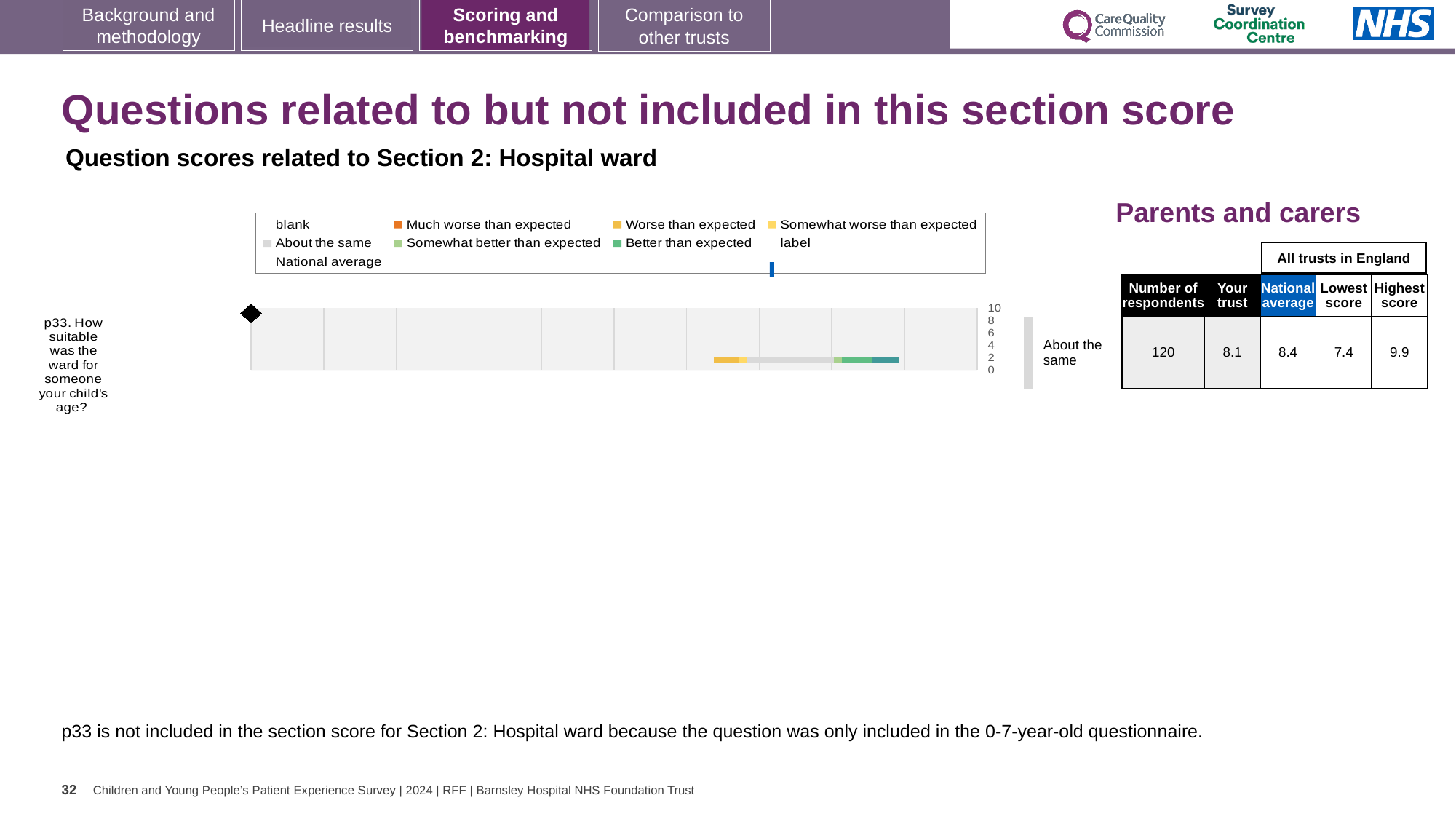
What is the highest score among all trusts in England for question p33? 9.9 What is the difference between the highest score and the lowest score for question p33? 2.5 Which benchmark category label is shown next to the chart for question p33? About the same How many questions (categories) are plotted in the chart? 1 What is the lowest score among all trusts in England for question p33? 7.4 What kind of chart is shown for question p33? bar chart Which is larger for question p33: the 'Your trust' score or the national average? National average How many respondents answered question p33? 120 What is the highest value shown on the chart's axis? 10 What is the 'Your trust' score for question p33 in the table? 8.1 What is the difference between the national average and the 'Your trust' score for question p33? 0.3 What is the national average score for question p33? 8.4